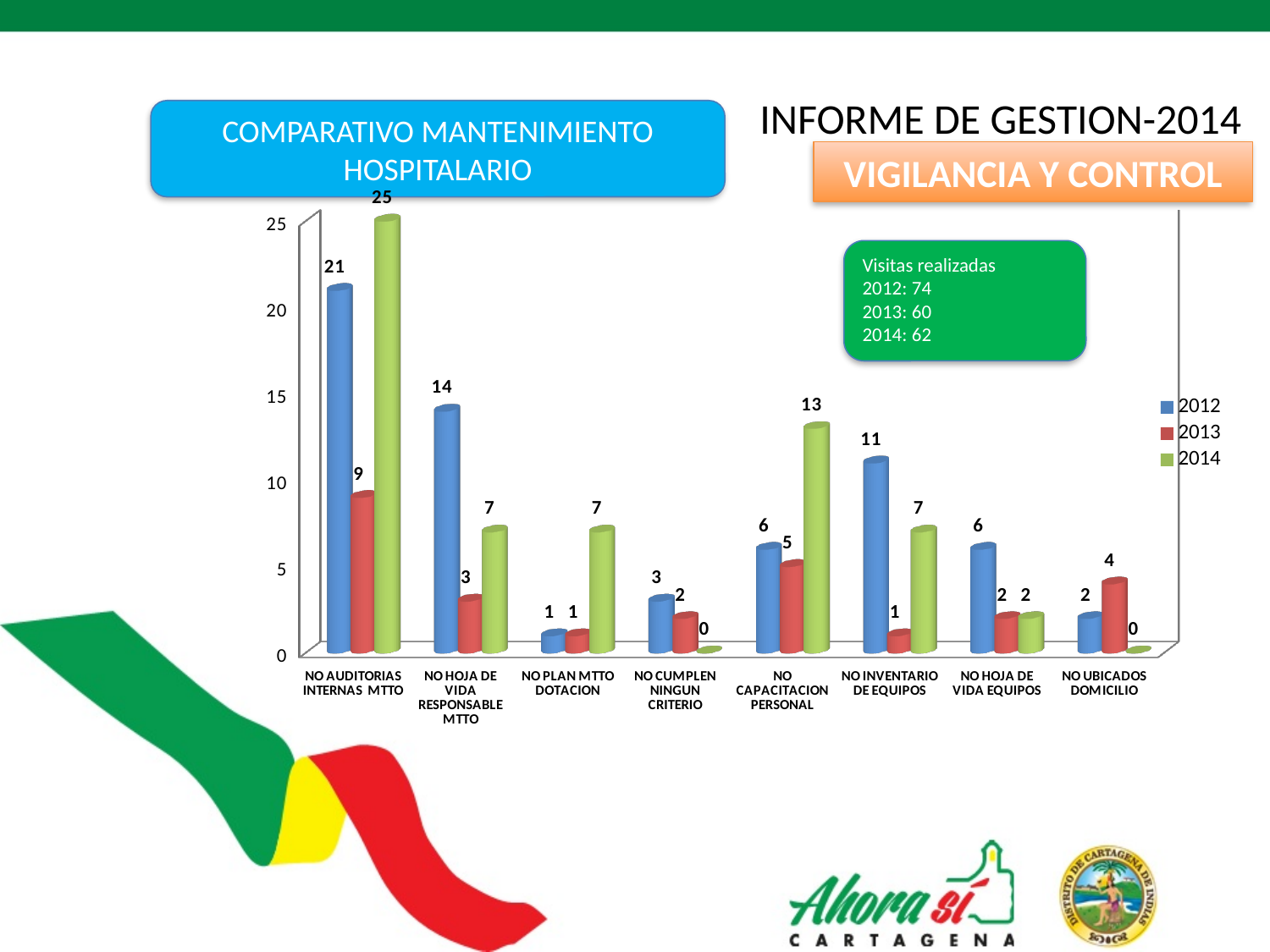
How many series does the chart legend list? 3 How many categories are shown on the x axis of the chart? 8 What is the 2014 value for NO CAPACITACION PERSONAL? 13 What is the 2013 value for NO UBICADOS DOMICILIO? 4 Which category has the highest 2014 value? NO AUDITORIAS INTERNAS MTTO Which category has the lowest 2012 value? NO PLAN MTTO DOTACION Is the 2014 value for NO AUDITORIAS INTERNAS MTTO greater or less than 20? greater Which is larger for NO INVENTARIO DE EQUIPOS, the 2012 value or the 2014 value? 2012 What is the difference between the 2012 and 2013 values for NO HOJA DE VIDA RESPONSABLE MTTO? 11 What is the 2012 value for NO AUDITORIAS INTERNAS MTTO? 21 What is the title of the chart? COMPARATIVO MANTENIMIENTO HOSPITALARIO What kind of chart is shown on the slide? bar chart